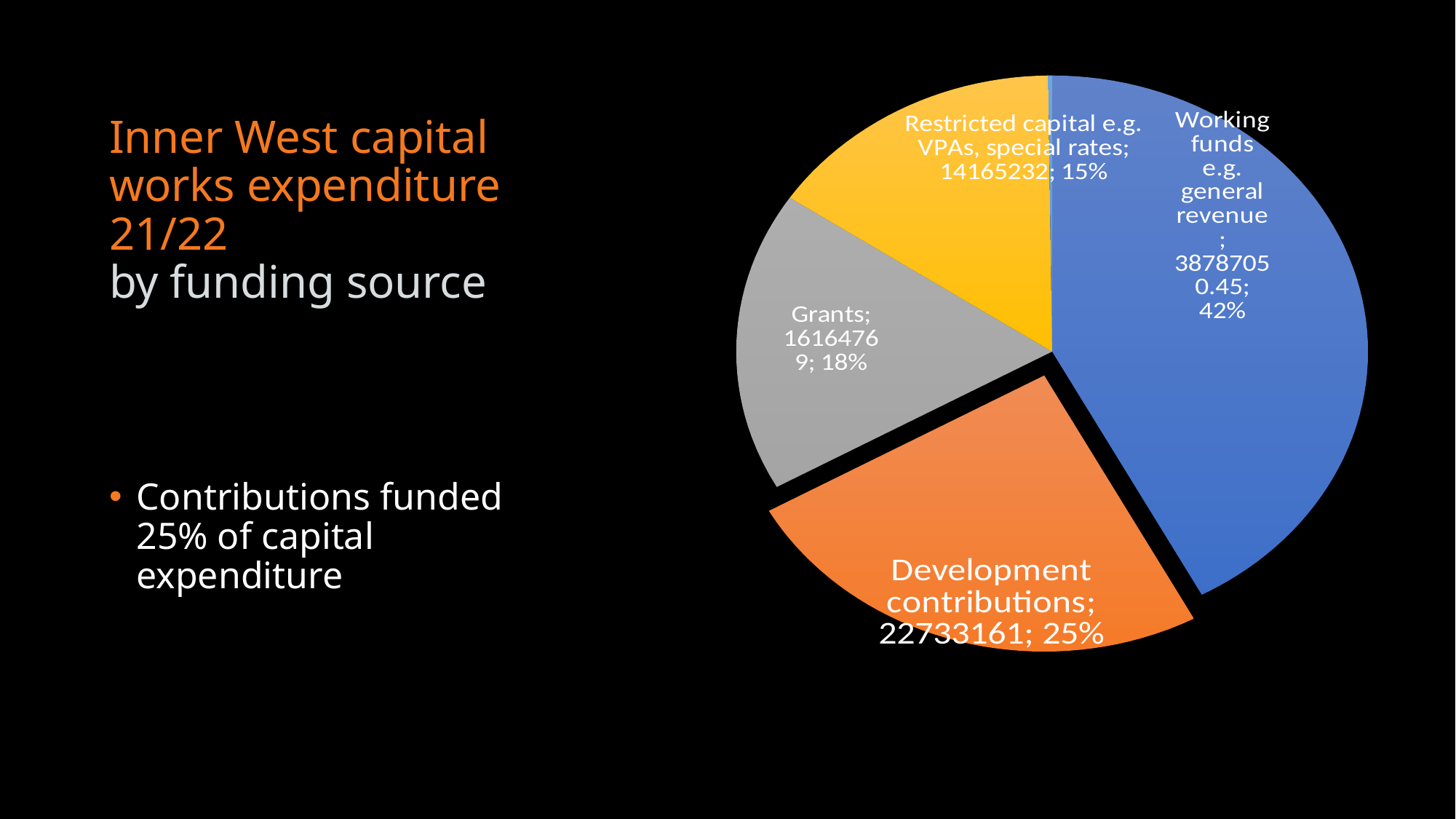
What share of capital works expenditure came from Working funds e.g. general revenue? 42% What share of capital works expenditure was funded by Development contributions? 25% Which is larger, the share for Grants or the share for Development contributions? Development contributions What share of capital works expenditure was funded by Grants? 18% Which funding source has the largest slice of the pie? Working funds e.g. general revenue What is the value shown for Restricted capital e.g. VPAs, special rates? 14165232 What kind of chart is shown on the slide? pie chart Which labelled funding source has the smallest share of the pie? Restricted capital e.g. VPAs, special rates What is the title of the slide containing the pie chart? Inner West capital works expenditure 21/22 by funding source What is the value shown for Development contributions? 22733161 By how many percentage points does the Working funds share exceed the Development contributions share? 17 percentage points